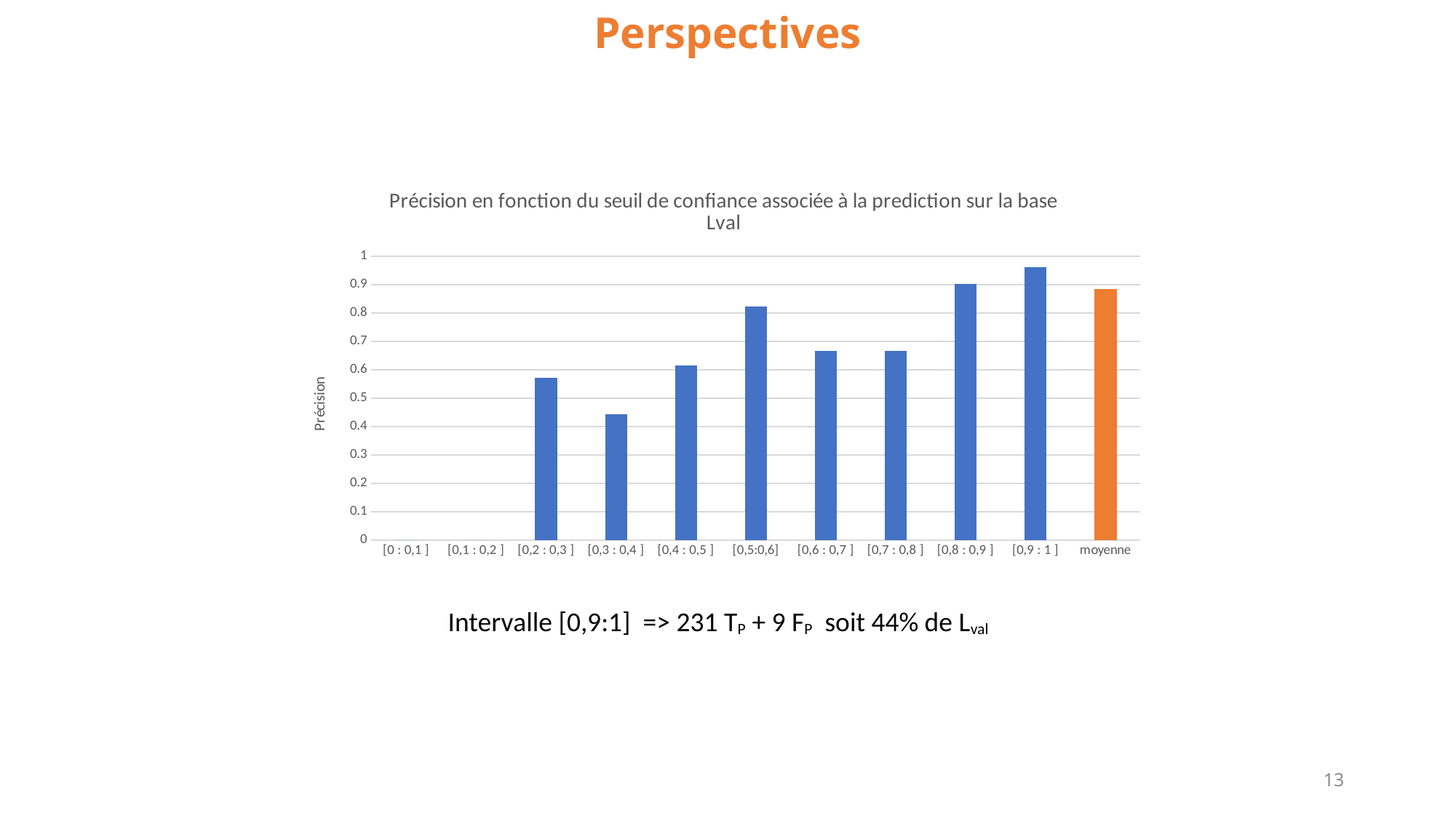
Which is larger, the value for [0,9 : 1 ] or the value for moyenne? [0,9 : 1 ] Which is larger, the value for [0,5:0,6] or the value for [0,6 : 0,7 ]? [0,5:0,6] Which category's bar is drawn in orange rather than blue? moyenne Is the value for [0,5:0,6] greater or less than 0.7? greater Is the value for [0,3 : 0,4 ] greater or less than 0.5? less Is the value for [0,6 : 0,7 ] greater or less than 0.7? less How many categories are labelled on the x axis of the chart? 11 What is the label of the vertical axis of the chart? Précision Which category has the tallest bar in the chart? [0,9 : 1 ] What kind of chart is shown on the slide? bar chart Among the categories with a visible bar, which has the shortest bar? [0,3 : 0,4 ]